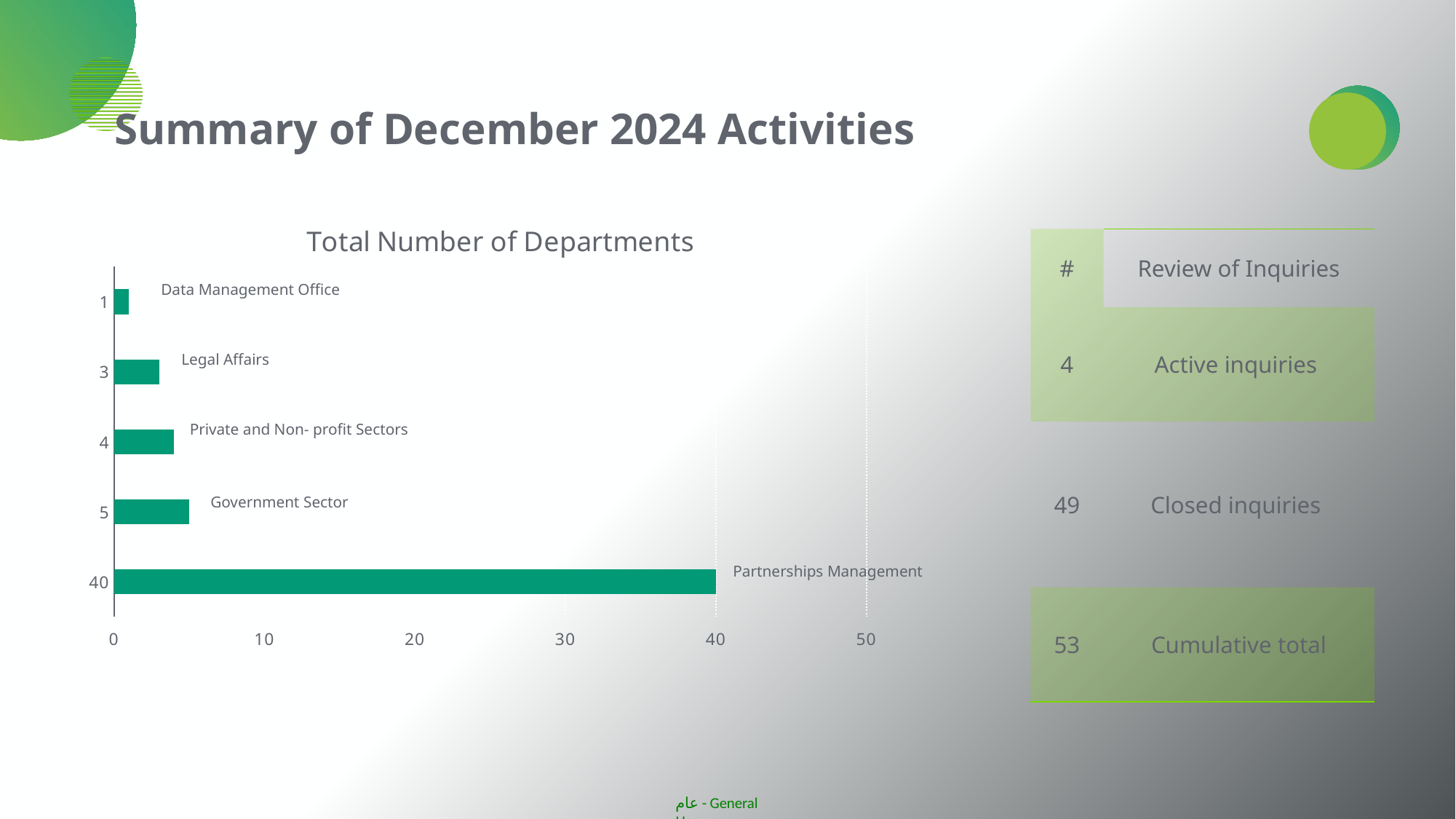
What is the value for Legal Affairs? 3 How many categories are shown in the chart? 5 Which category has the lowest value? Data Management Office Which category has the highest value? Partnerships Management What is the title of the chart? Total Number of Departments Which is larger, the value for Government Sector or the value for Legal Affairs? Government Sector What is the value for Data Management Office? 1 What is the difference between the values for Private and Non- profit Sectors and Legal Affairs? 1 What is the difference between the values for Partnerships Management and Government Sector? 35 What is the value for Partnerships Management? 40 What kind of chart is shown on the slide? bar chart What is the value for Government Sector? 5